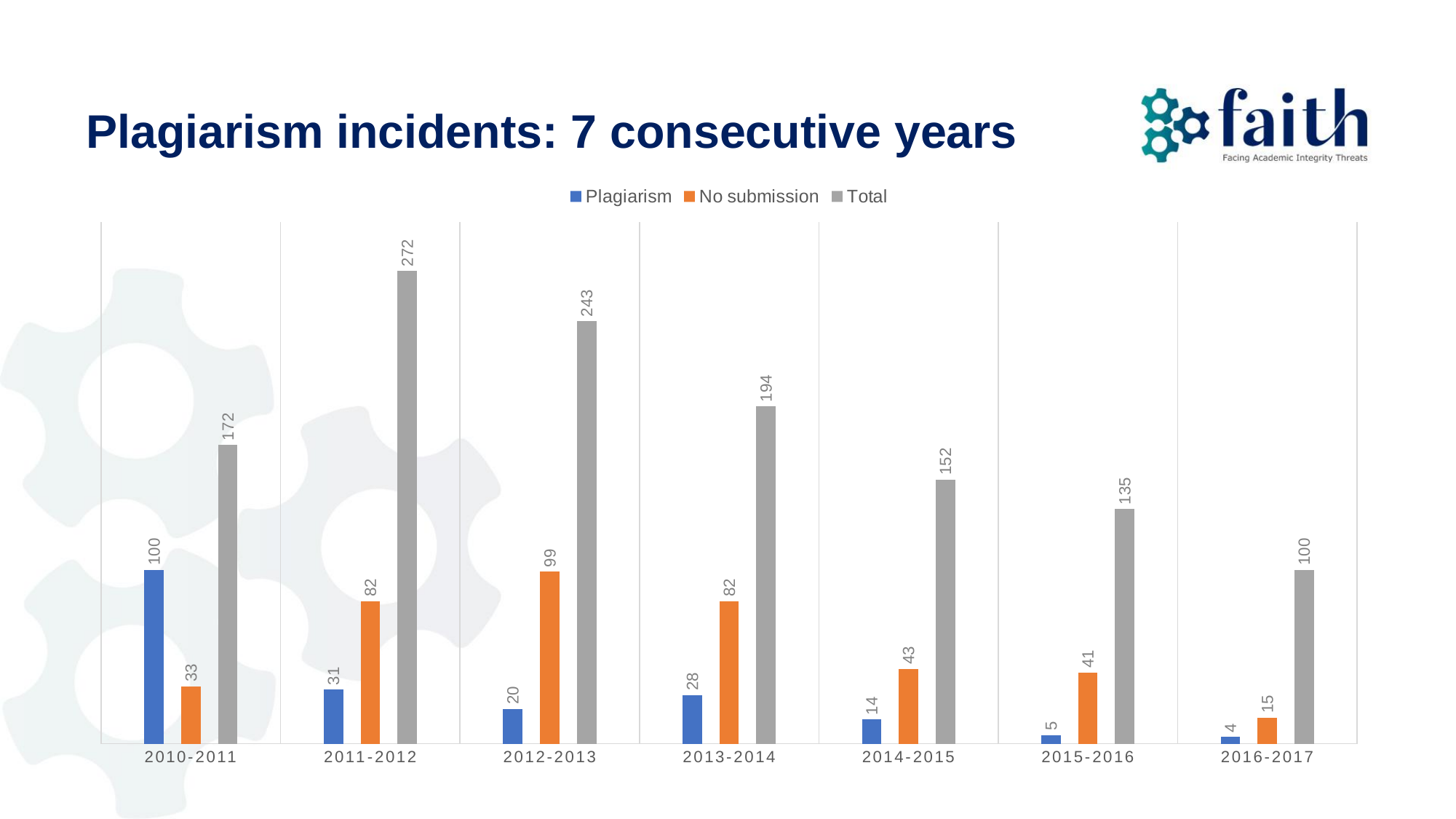
Which year has the lowest Plagiarism value? 2016-2017 How many series does the legend list? 3 Do the Total values rise or fall from 2011-2012 to 2016-2017? Fall What is the No submission value for 2012-2013? 99 Which is larger, the No submission value for 2013-2014 or for 2014-2015? 2013-2014 What kind of chart is shown on the slide? Bar chart What is the difference between the Total values for 2011-2012 and 2012-2013? 29 What is the Total value for 2014-2015? 152 Which year has the highest Total value? 2011-2012 What is the title of the slide? Plagiarism incidents: 7 consecutive years How many years are shown on the x axis? 7 What is the Plagiarism value for 2010-2011? 100